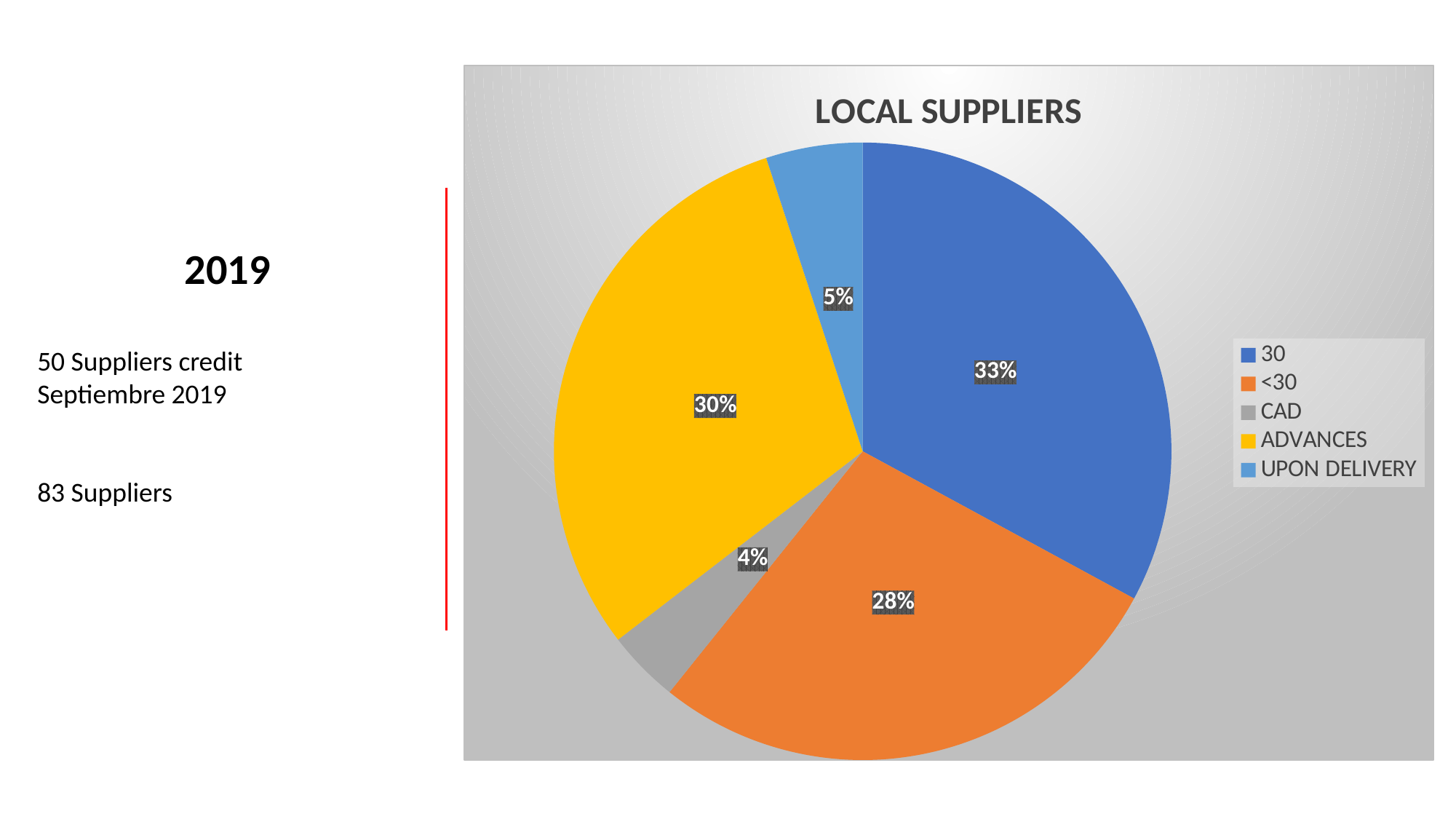
Which slice is larger, 'ADVANCES' or '<30'? ADVANCES What is the title of the chart? LOCAL SUPPLIERS What type of chart is shown on the slide? pie chart How many categories does the legend list? 5 What is the difference in percentage points between the '30' slice and the '<30' slice? 5 Which category has the smallest slice of the pie? CAD What percentage of the pie does the 'ADVANCES' slice represent? 30% What percentage of the pie does the '<30' slice represent? 28% Which category has the largest slice of the pie? 30 What percentage of the pie does the 'UPON DELIVERY' slice represent? 5%